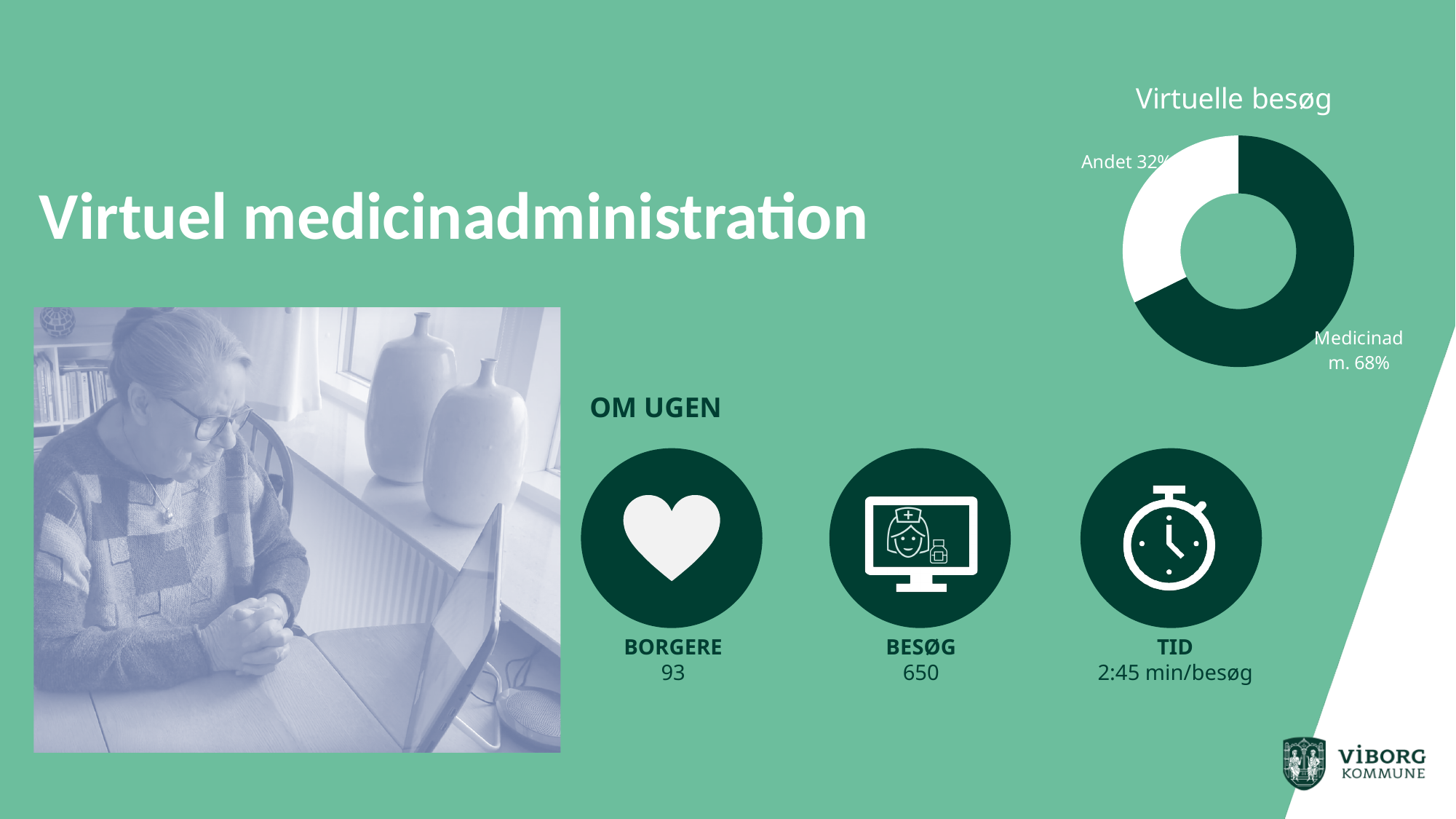
In the 'Virtuelle besøg' chart, by how many percentage points does Medicinadm. exceed Andet? 36 percentage points What kind of chart is 'Virtuelle besøg'? Doughnut (pie) chart What is the title of the chart on the slide? Virtuelle besøg In the 'Virtuelle besøg' chart, what colour is the Medicinadm. slice? Dark green In the 'Virtuelle besøg' chart, is the share for Andet greater or less than 50%? less What share of the 'Virtuelle besøg' chart does Andet represent? 32% Which slice of the 'Virtuelle besøg' chart is the largest? Medicinadm. In the 'Virtuelle besøg' chart, what percentage is shown for Andet? 32% In the 'Virtuelle besøg' chart, which is larger: Medicinadm. or Andet? Medicinadm. How many slices does the 'Virtuelle besøg' chart have? 2 Which slice of the 'Virtuelle besøg' chart is the smallest? Andet In the 'Virtuelle besøg' chart, what percentage is shown for Medicinadm.? 68%